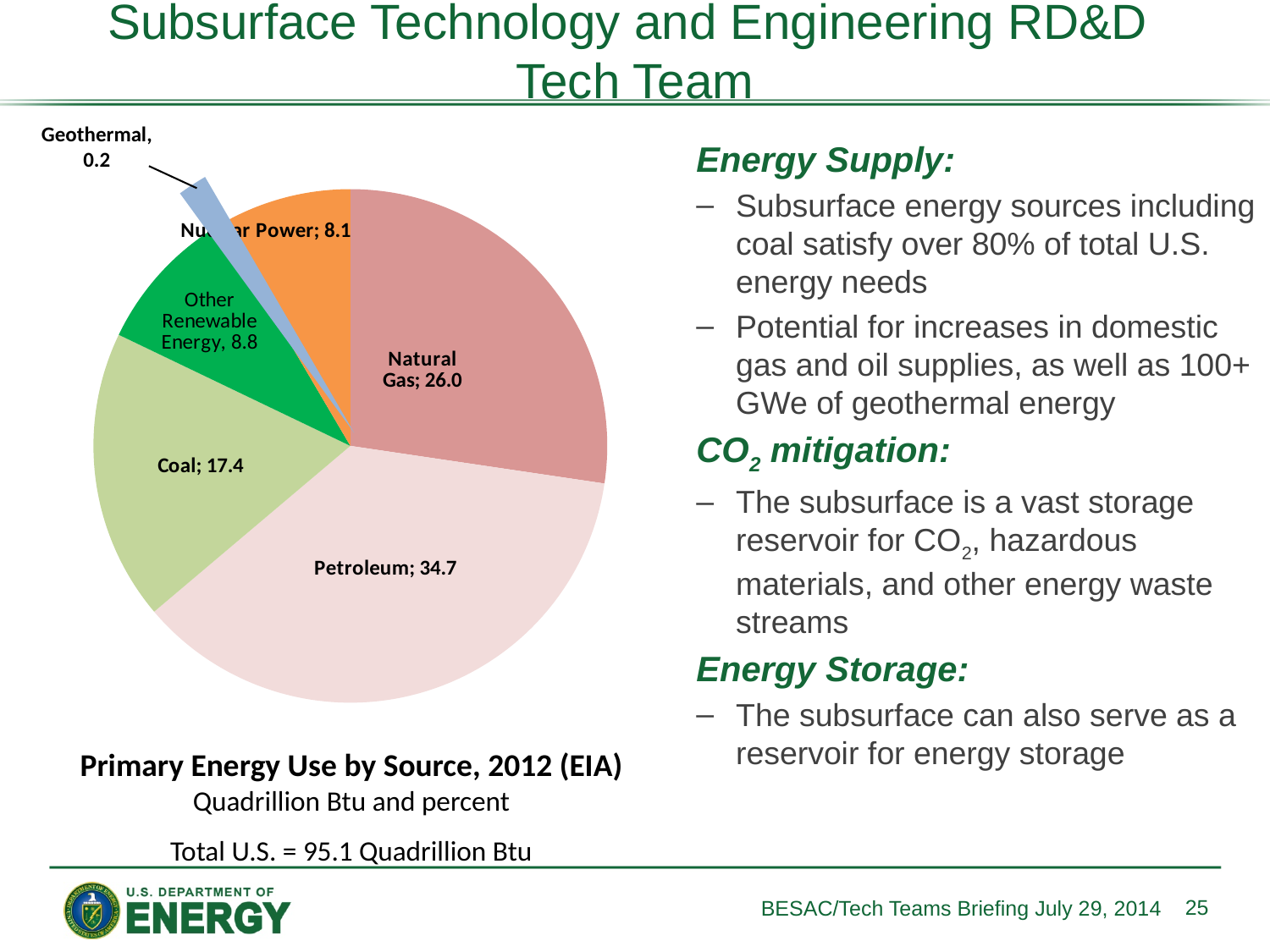
What is the value for Coal in the pie chart? 17.4 Which energy source has the largest slice of the pie chart? Petroleum What is the difference between the Petroleum and Natural Gas values in the pie chart? 8.7 What is the difference between the Coal and Nuclear Power values in the pie chart? 9.3 Which energy source has the smallest slice of the pie chart? Geothermal Which is larger in the pie chart, Other Renewable Energy or Nuclear Power? Other Renewable Energy What is the value for Petroleum in the pie chart? 34.7 What is the value for Natural Gas in the pie chart? 26.0 What is the value for Geothermal in the pie chart? 0.2 What kind of chart is shown on the slide? Pie chart How many energy source categories are shown in the pie chart? 6 What is the title of the pie chart? Primary Energy Use by Source, 2012 (EIA)